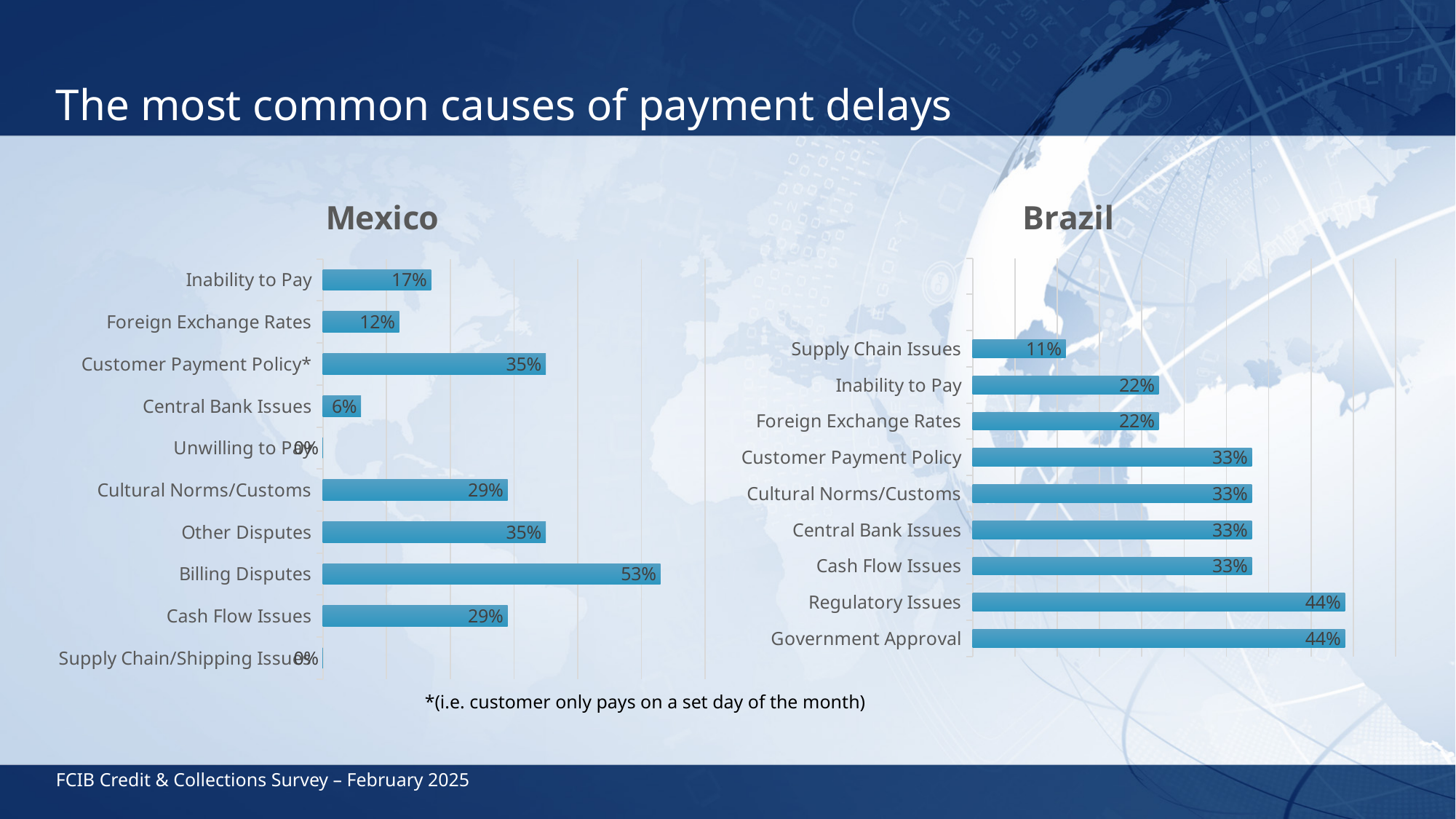
In the Brazil chart, what is the value for Supply Chain Issues? 11% In the Brazil chart, what is the difference between Government Approval and Inability to Pay? 22% In the Mexico chart, which category has the highest value? Billing Disputes In the Mexico chart, what is the difference between Billing Disputes and Cash Flow Issues? 24% In the Brazil chart, what is the value for Regulatory Issues? 44% In the Mexico chart, how many categories are shown? 10 What type of chart is the Brazil chart? Bar chart In the Mexico chart, which is larger, Inability to Pay or Foreign Exchange Rates? Inability to Pay In the Brazil chart, how many categories are shown? 9 In the Mexico chart, what is the value for Billing Disputes? 53% In the Mexico chart, what is the value for Central Bank Issues? 6% In the Brazil chart, which category has the lowest value? Supply Chain Issues